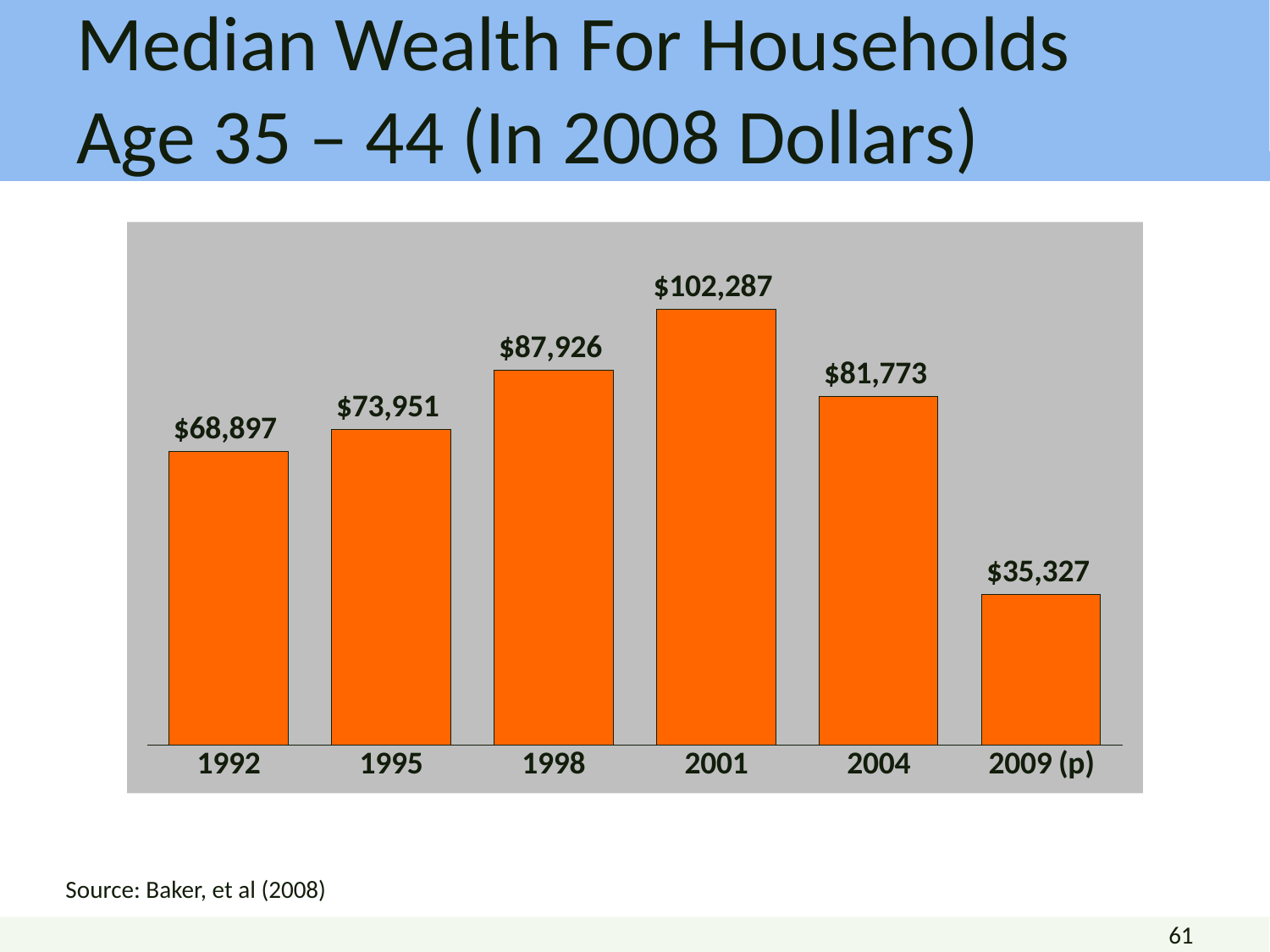
Which is larger, the median wealth in 1998 or in 2004? 1998 What is the difference in median wealth between 2001 and 2009 (p)? $66,960 How many years are shown on the chart? 6 What is the median wealth for households age 35–44 in 2004? $81,773 Which year has the highest median wealth? 2001 What is the median wealth for households age 35–44 in 1992? $68,897 Which year has the lowest median wealth? 2009 (p) What is the difference in median wealth between 1998 and 1995? $13,975 What kind of chart is shown on the slide? Bar chart What is the median wealth for households age 35–44 in 2009 (p)? $35,327 Does median wealth rise or fall from 1992 to 2001? Rise What is the median wealth for households age 35–44 in 2001? $102,287